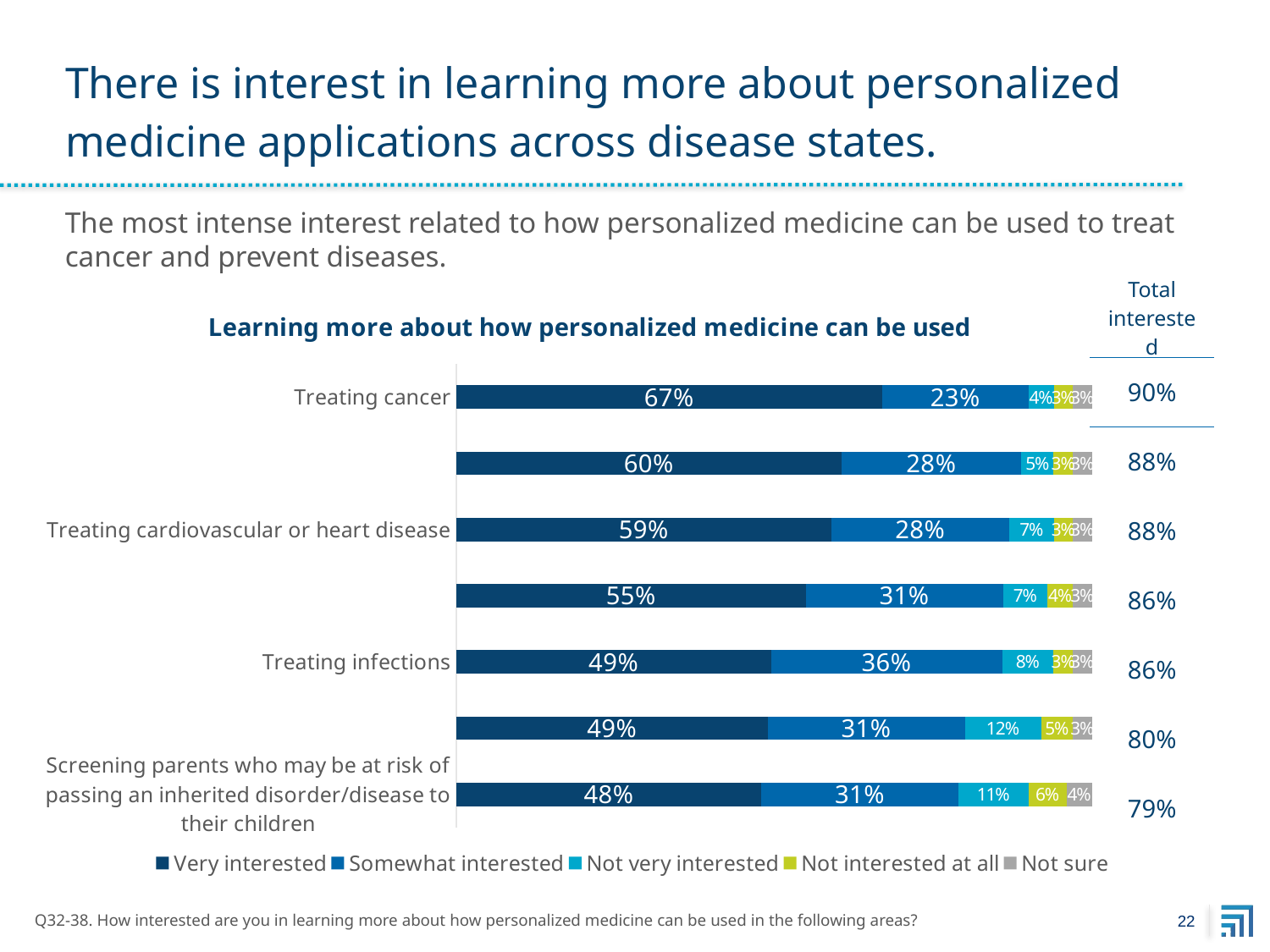
What percentage of respondents are "Very interested" in learning more about how personalized medicine can be used for treating cancer? 67% Which category has the lowest "Total interested" value? Screening parents who may be at risk of passing an inherited disorder/disease to their children What percentage of respondents are "Not very interested" in learning more about screening parents who may be at risk of passing an inherited disorder/disease to their children? 11% What percentage of respondents are "Somewhat interested" in learning more about treating infections? 36% What is the "Total interested" value for screening parents who may be at risk of passing an inherited disorder/disease to their children? 79% What percentage of respondents are "Very interested" in learning more about treating cardiovascular or heart disease? 59% What kind of chart is shown on the slide? Stacked bar chart How many bars are plotted in the chart? 7 Which labeled category has the highest "Very interested" percentage? Treating cancer How many series does the legend list? 5 Which has a larger "Somewhat interested" share: treating infections or treating cardiovascular or heart disease? Treating infections How many percentage points higher is the "Very interested" share for treating cancer than for treating infections? 18 percentage points